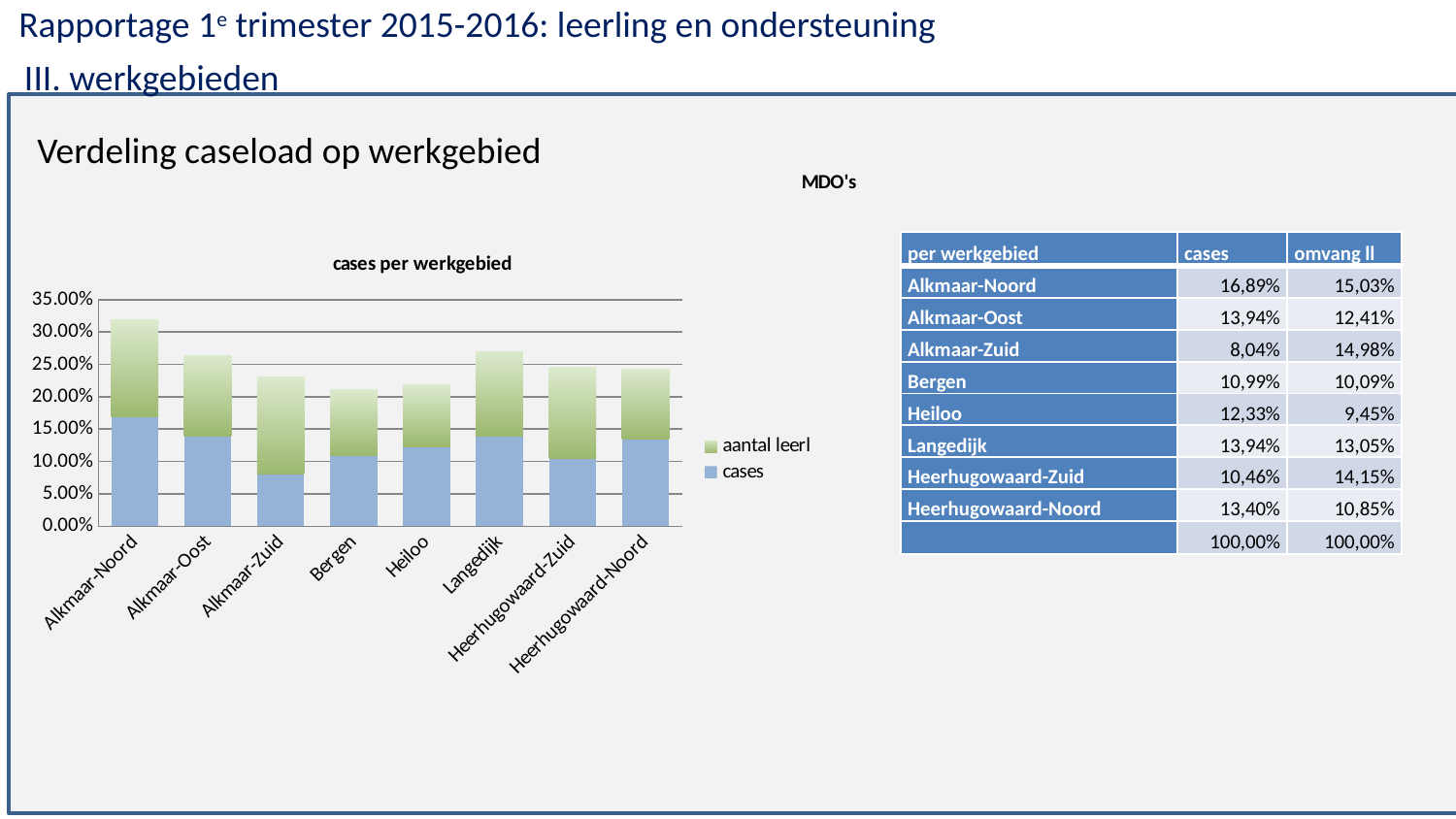
Which series is shown in green in the chart? aantal leerl Which has the larger cases value, Heiloo or Alkmaar-Zuid? Heiloo Which werkgebied has the lowest value for cases in the chart? Alkmaar-Zuid What kind of chart is shown on the slide? Bar chart Which werkgebied has the tallest stacked bar overall in the chart? Alkmaar-Noord Which werkgebied has the highest value for cases in the chart? Alkmaar-Noord How many werkgebieden (categories) are shown on the x axis of the chart? 8 What is the title of the chart? cases per werkgebied Is the total stacked bar for Langedijk greater or less than 25.00%? greater Is the cases value for Alkmaar-Noord greater or less than 15.00%? greater How many series does the chart legend list? 2 Is the cases value for Alkmaar-Zuid greater or less than 10.00%? less